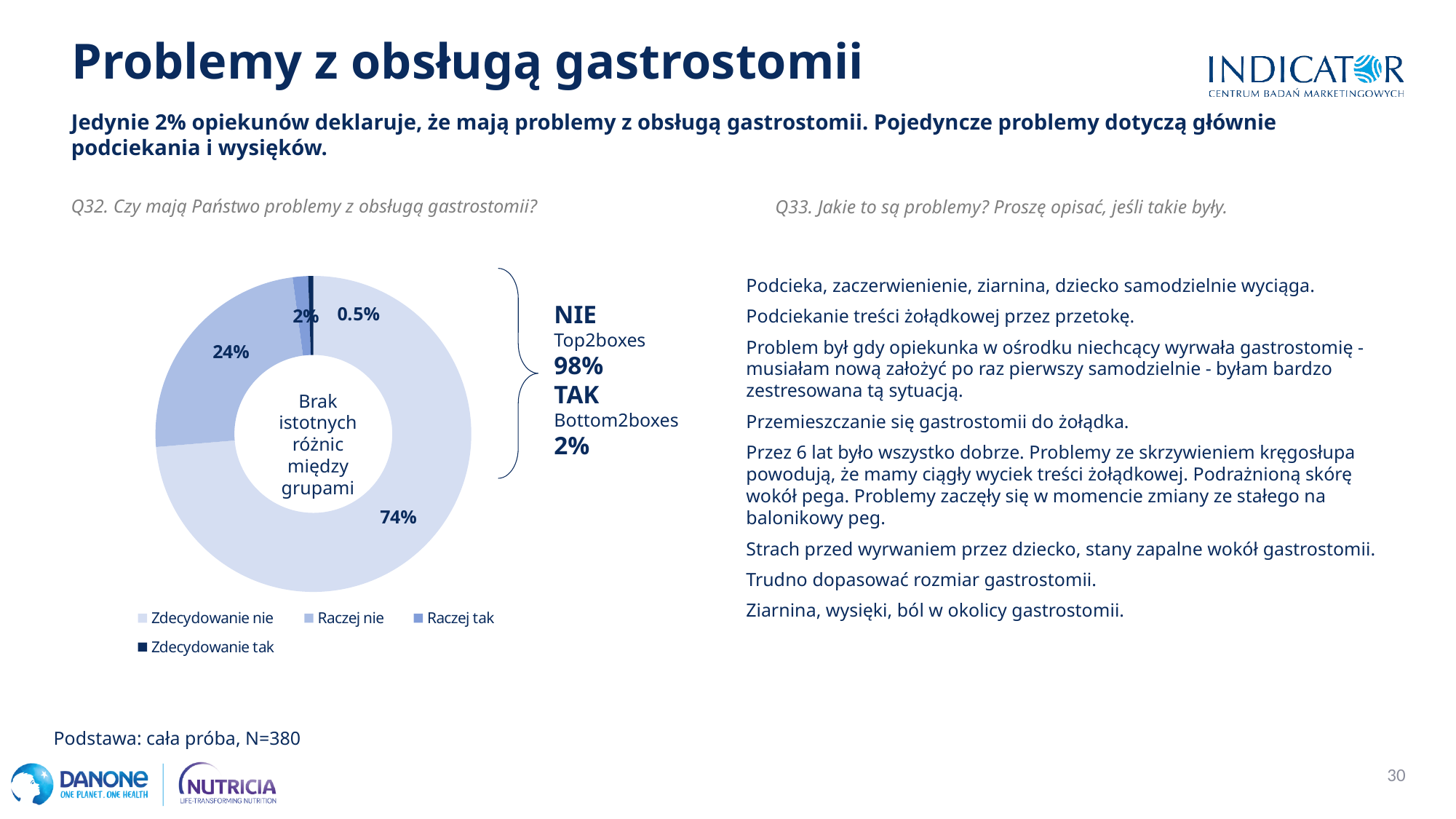
What is the combined Top2boxes (NIE) percentage shown next to the pie chart? 98% What type of chart is shown on the slide? Pie chart (donut) Which category has the largest share in the pie chart? Zdecydowanie nie What is the value for "Raczej nie" in the pie chart? 24% What is the value for "Zdecydowanie tak" in the pie chart? 0.5% What text is written in the centre of the donut chart? Brak istotnych różnic między grupami What is the value for "Raczej tak" in the pie chart? 2% Which category has the smallest share in the pie chart? Zdecydowanie tak What is the value for "Zdecydowanie nie" in the pie chart? 74% What is the difference between the shares of "Zdecydowanie nie" and "Raczej nie"? 50 percentage points Which is larger: the share of "Raczej nie" or the share of "Raczej tak"? Raczej nie How many categories does the legend of the pie chart list? 4